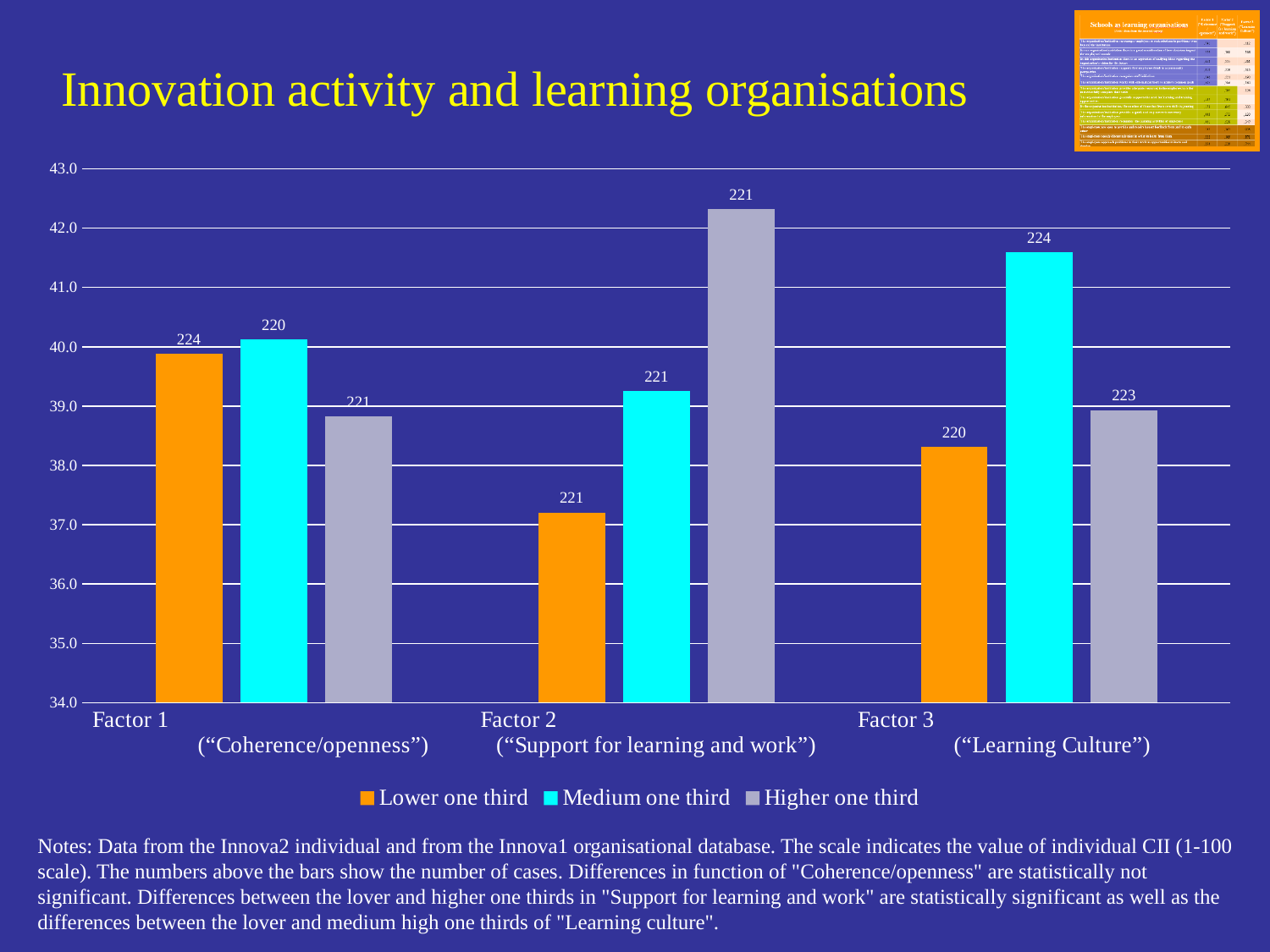
What number of cases is printed above the Lower one third bar for Factor 1? 224 Which series has the tallest bar for Factor 2 ("Support for learning and work")? Higher one third Is the value for Medium one third in Factor 3 greater or less than 41.0? greater For Factor 3, which is larger: the Medium one third bar or the Higher one third bar? Medium one third How many factor categories are shown on the x axis? 3 Is the value for Lower one third in Factor 2 greater or less than 38.0? less Is the value for Higher one third in Factor 2 greater or less than 42.0? greater What colour represents the Lower one third series in the legend? Orange Which series has the tallest bar for Factor 3 ("Learning Culture")? Medium one third Which series has the shortest bar for Factor 2 ("Support for learning and work")? Lower one third What kind of chart is shown on the slide? Bar chart How many series does the legend list? 3